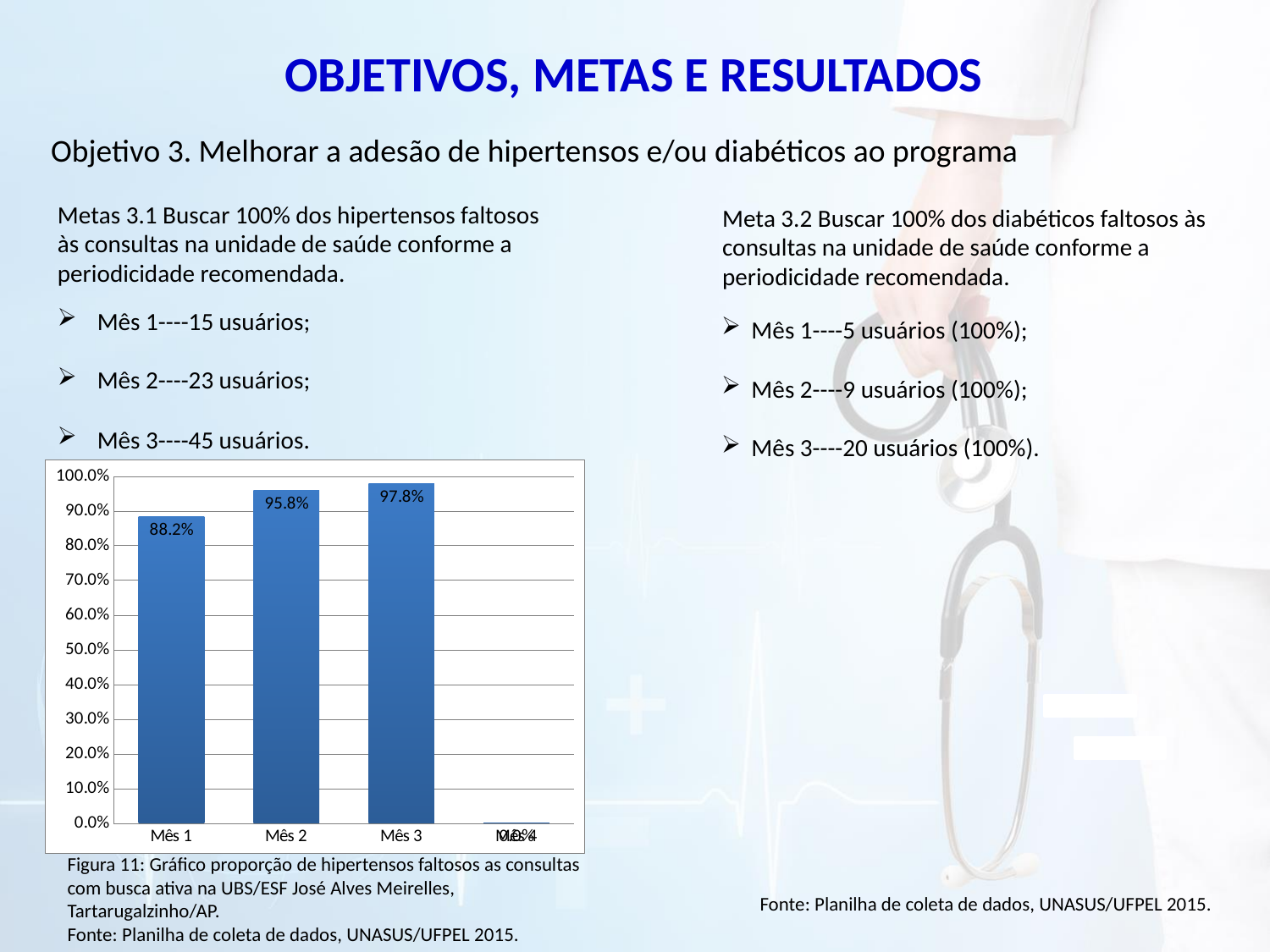
What is the difference between the values for Mês 2 and Mês 1? 7.6 percentage points What type of chart is shown on the slide? Bar chart Do the values rise or fall from Mês 1 to Mês 3? rise Which month has the highest value in the chart? Mês 3 What is the value for Mês 3 in the chart? 97.8% What is the value for Mês 2 in the chart? 95.8% What is the maximum value shown on the vertical axis of the chart? 100.0% Among Mês 1, Mês 2 and Mês 3, which has the lowest value? Mês 1 Which is larger, the value for Mês 2 or the value for Mês 3? Mês 3 What is the value for Mês 1 in the chart? 88.2% What is the difference between the values for Mês 3 and Mês 1? 9.6 percentage points Is the value for Mês 1 greater or less than 90.0%? less